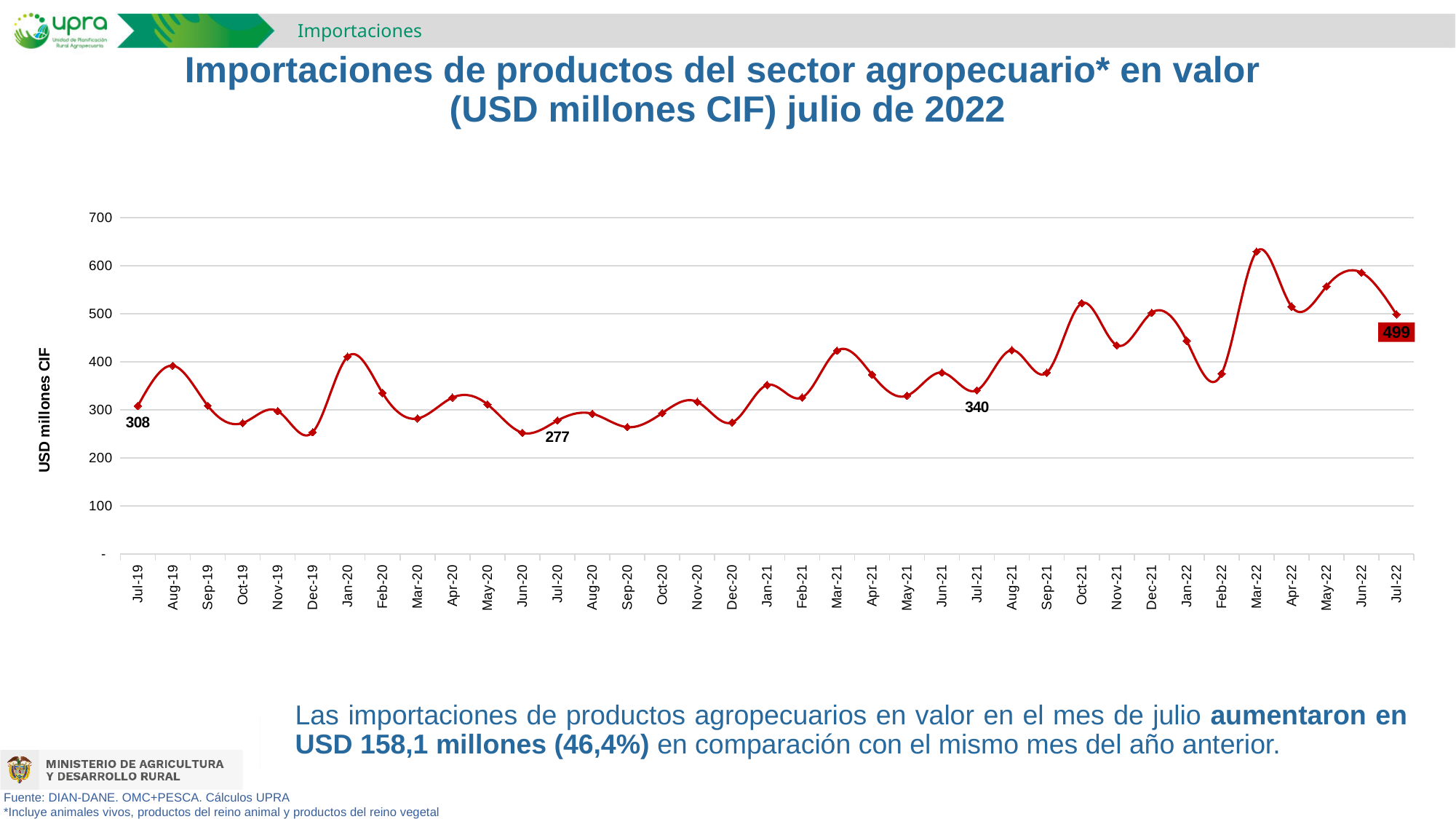
How many monthly data points are plotted on the chart? 37 What is the value for Jul-19? 308 Which is larger, the value for Jul-22 or the value for Jul-19? Jul-22 Which month has the highest value on the chart? Mar-22 What is the difference between the values for Jul-21 and Jul-20? 63 Is the value for Mar-22 greater or less than 600? greater What is the value for Jul-22? 499 Is the value for Dec-19 greater or less than 300? less What kind of chart is shown on the slide? line chart What is the value for Jul-21? 340 What is the value for Jul-20? 277 What is the difference between the values for Jul-22 and Jul-21? 159